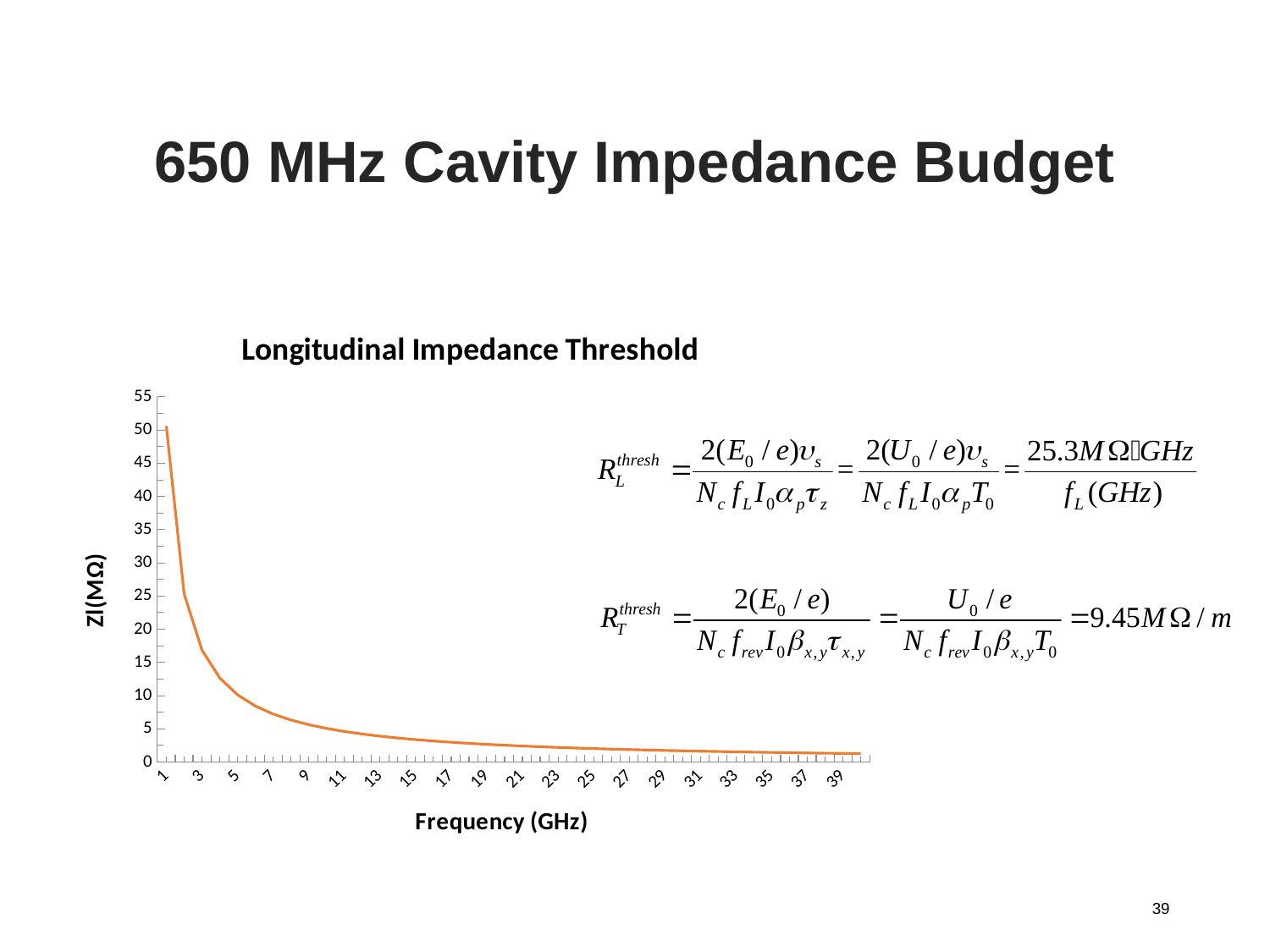
At which frequency is the impedance threshold highest? 1 GHz Which has the larger impedance threshold, 3 GHz or 9 GHz? 3 GHz What is the label of the x axis of the chart? Frequency (GHz) What is the title of the chart? Longitudinal Impedance Threshold Is the value at 7 GHz greater or less than 10? less Is the value at 39 GHz greater or less than 5? less Is the value at 1 GHz greater or less than 45? greater Do the values rise or fall as frequency increases along the x axis? fall What kind of chart is shown on the slide? line chart